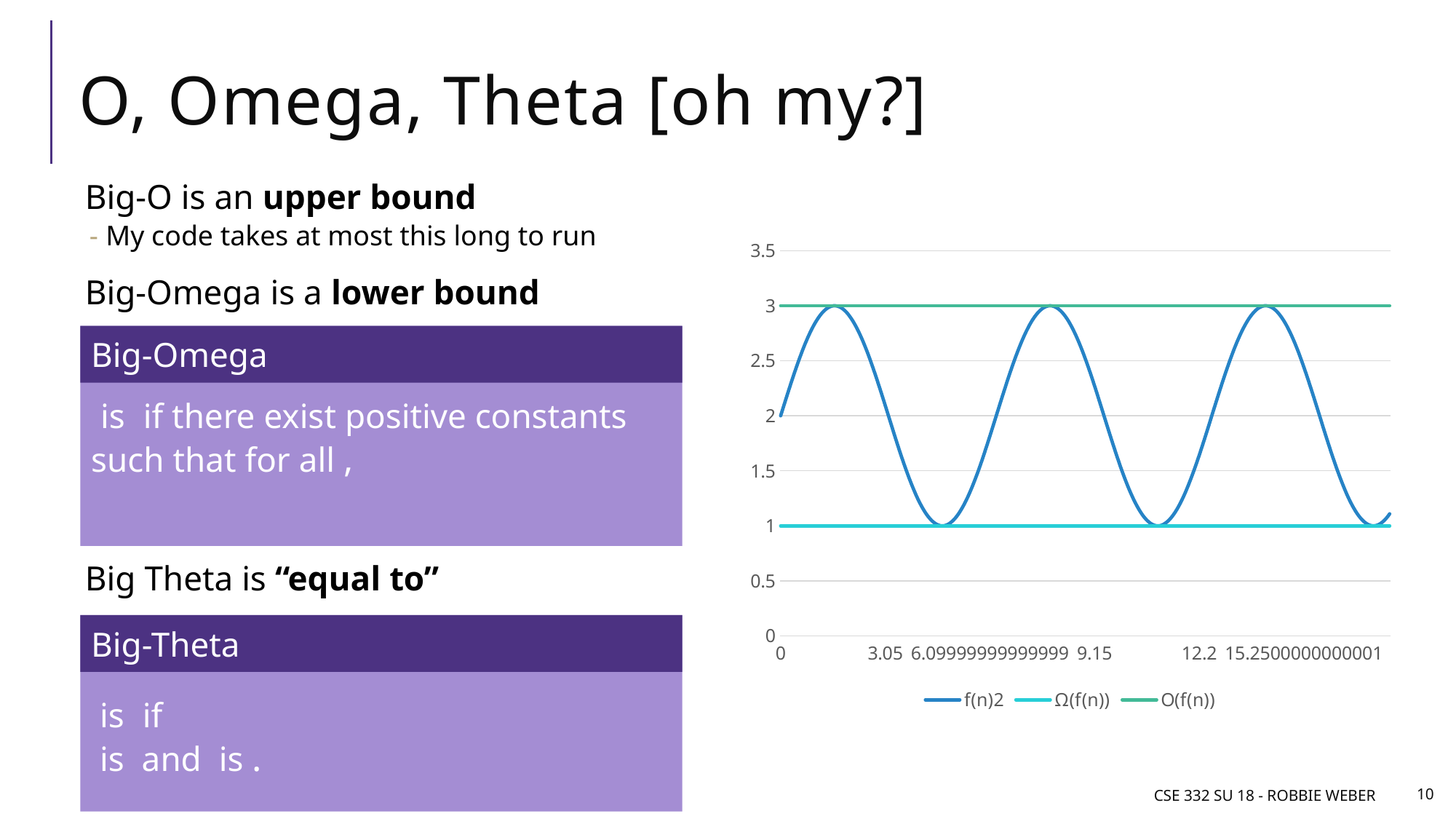
Does the f(n)2 series rise or fall immediately after x = 0? rise What constant value does the O(f(n)) line sit at? 3 How many series does the chart's legend list? 3 Which horizontal line is higher, O(f(n)) or Ω(f(n))? O(f(n)) What is the lowest value reached by the f(n)2 series? 1 What is the highest tick label on the y axis? 3.5 At x = 0, is the value of f(n)2 greater or less than 2.5? less What is the difference between the O(f(n)) line value and the Ω(f(n)) line value? 2 What constant value does the Ω(f(n)) line sit at? 1 What colour is the f(n)2 line in the chart? blue What kind of chart is shown on the slide? line chart What is the highest value reached by the f(n)2 series? 3